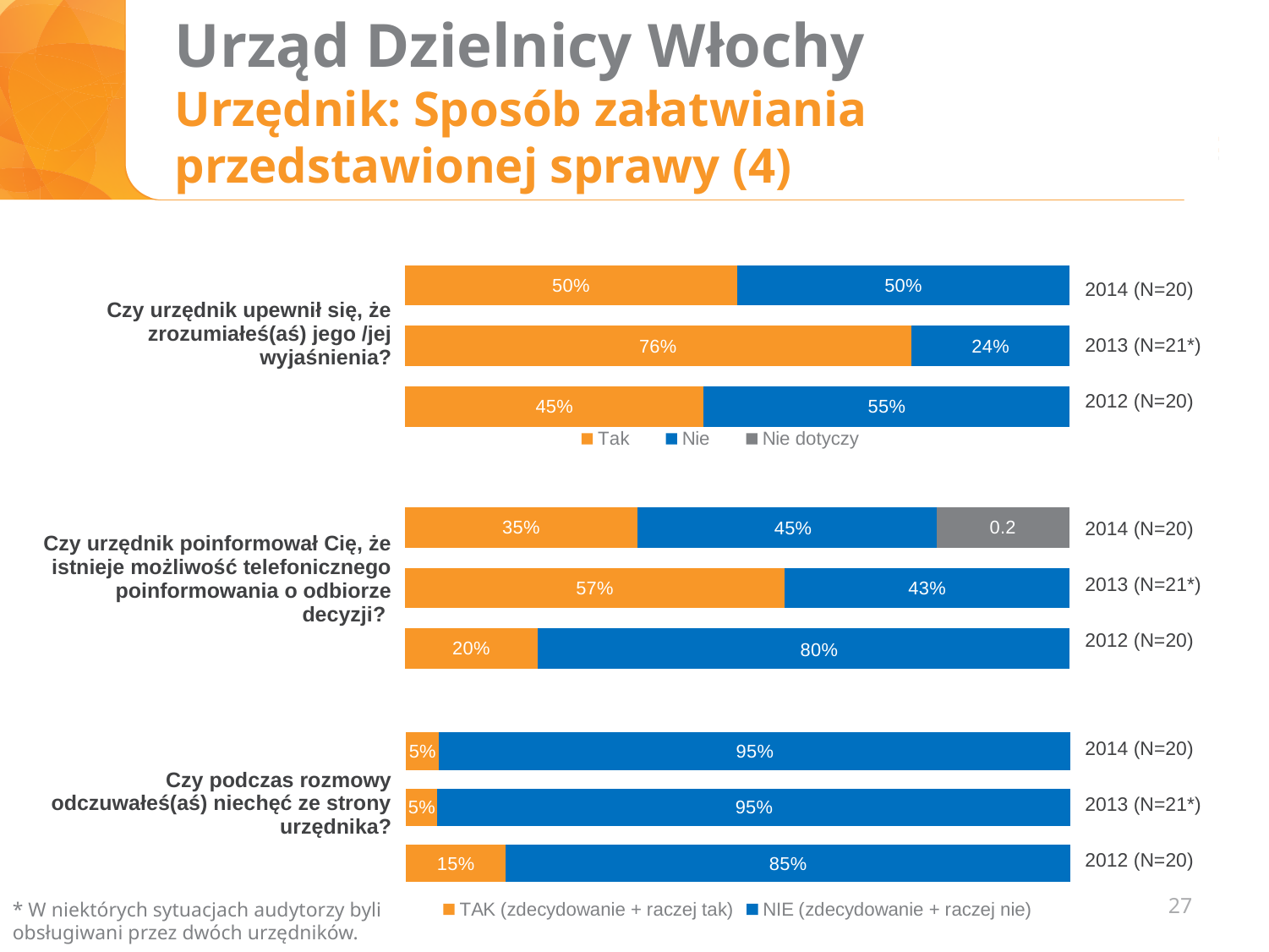
In the chart for "Czy urzędnik poinformował Cię, że istnieje możliwość telefonicznego poinformowania o odbiorze decyzji?", what is the "Nie" value for 2012 (N=20)? 80% What type of chart is used for "Czy podczas rozmowy odczuwałeś(aś) niechęć ze strony urzędnika?"? Stacked bar chart In the chart for "Czy urzędnik poinformował Cię, że istnieje możliwość telefonicznego poinformowania o odbiorze decyzji?", what is the label shown on the grey "Nie dotyczy" segment for 2014 (N=20)? 0.2 In the chart for "Czy urzędnik poinformował Cię, że istnieje możliwość telefonicznego poinformowania o odbiorze decyzji?", which year has the lowest "Tak" value? 2012 (N=20) In the chart for "Czy urzędnik upewnił się, że zrozumiałeś(aś) jego /jej wyjaśnienia?", how many series does the legend list? 3 In the chart for "Czy urzędnik upewnił się, że zrozumiałeś(aś) jego /jej wyjaśnienia?", what is the "Nie" value for 2012 (N=20)? 55% In the chart for "Czy podczas rozmowy odczuwałeś(aś) niechęć ze strony urzędnika?", how many year bars are shown? 3 In the chart for "Czy urzędnik poinformował Cię, że istnieje możliwość telefonicznego poinformowania o odbiorze decyzji?", what is the difference between the "Tak" values for 2013 (N=21*) and 2014 (N=20)? 22% In the chart for "Czy podczas rozmowy odczuwałeś(aś) niechęć ze strony urzędnika?", is the "NIE" value for 2014 (N=20) larger or smaller than the "NIE" value for 2012 (N=20)? larger In the chart for "Czy urzędnik upewnił się, że zrozumiałeś(aś) jego /jej wyjaśnienia?", what is the "Tak" value for 2013 (N=21*)? 76% In the chart for "Czy urzędnik upewnił się, że zrozumiałeś(aś) jego /jej wyjaśnienia?", which year has the highest "Tak" value? 2013 (N=21*) In the chart for "Czy podczas rozmowy odczuwałeś(aś) niechęć ze strony urzędnika?", what is the "TAK" value for 2012 (N=20)? 15%